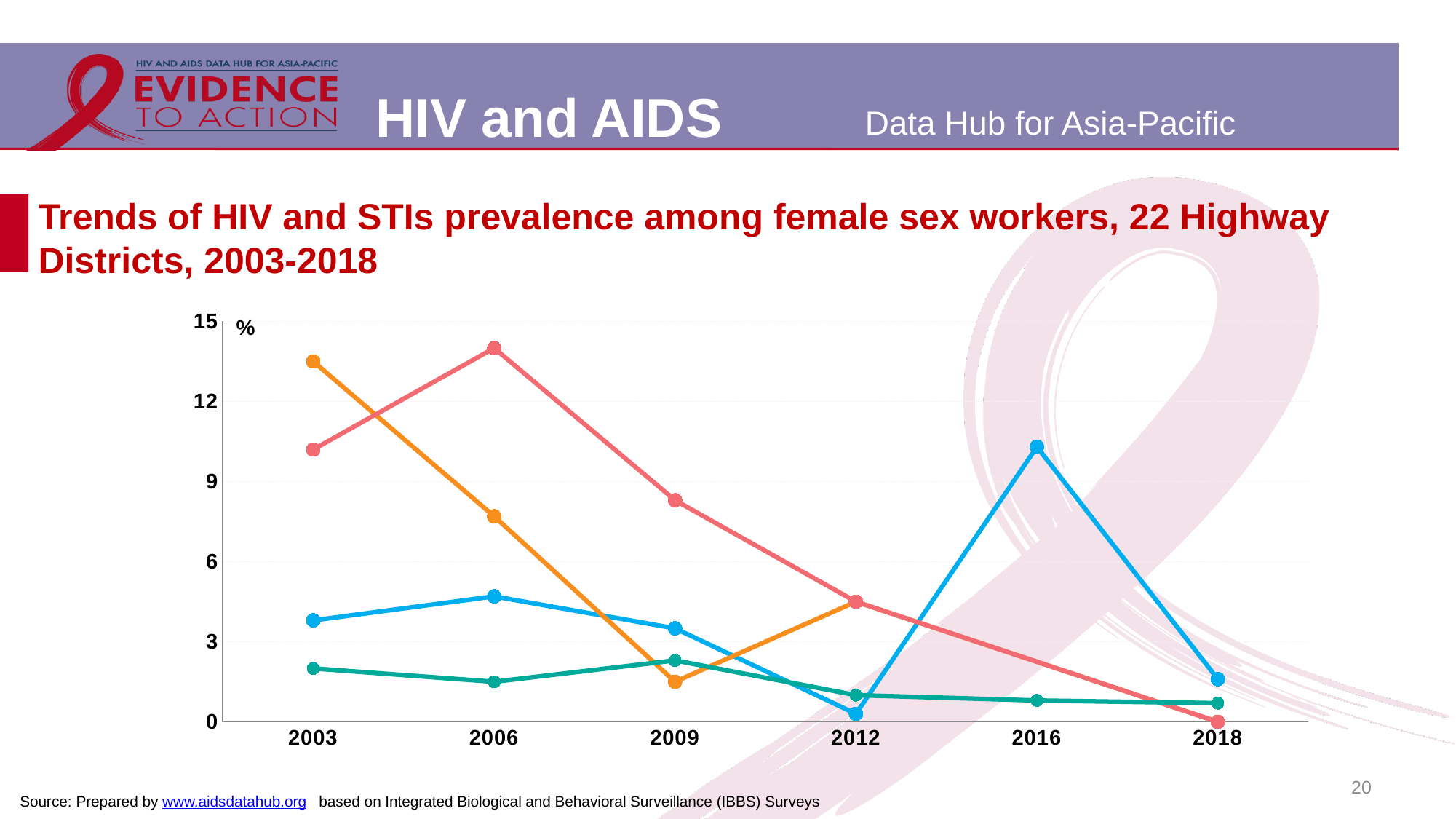
Is the value of the red line in 2009 greater or less than 9? less What kind of chart is shown on the slide? Line chart What is the value of the red line in 2018? 0 How many years are plotted along the x axis of the chart? 6 In 2003, which line has the higher value, the red line or the blue line? The red line Is the value of the blue line in 2016 greater or less than 9? greater How many lines are plotted on the chart? 4 Is the value of the orange line in 2003 greater or less than 12? greater Does the orange line rise or fall between 2003 and 2009? Fall In which year does the blue line reach its highest value? 2016 In which year does the red line reach its highest value? 2006